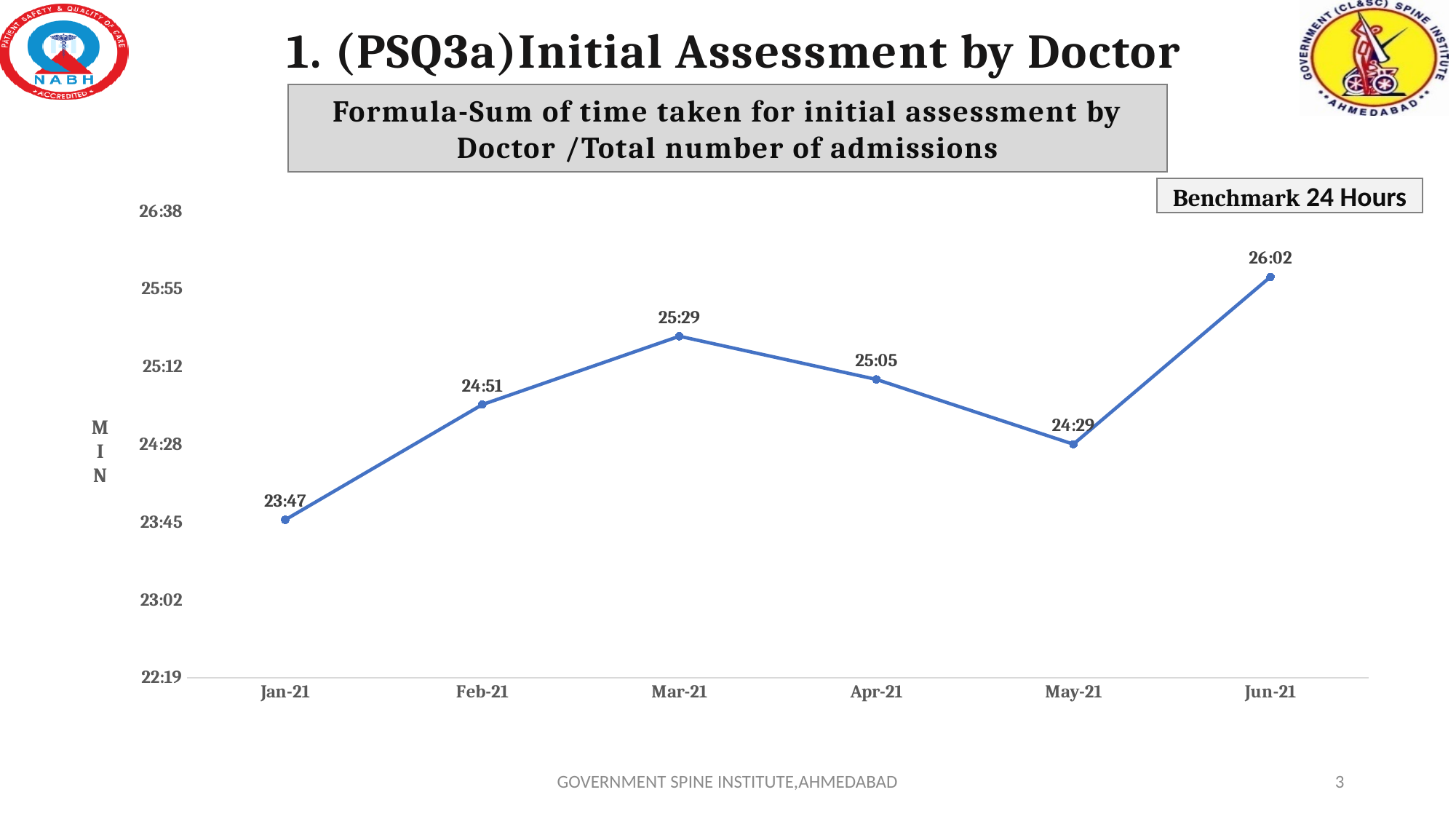
Which is larger, the value for Feb-21 or the value for Apr-21? Apr-21 Does the value rise or fall from Mar-21 to May-21? Fall Which month has the lowest value? Jan-21 By how much does the value for Jun-21 exceed the value for Jan-21? 2:15 What is the value for Mar-21? 25:29 What benchmark is stated on the slide? 24 Hours What is the value for Jun-21? 26:02 What is the value for May-21? 24:29 What kind of chart is shown on the slide? Line chart What is the value for Jan-21? 23:47 Which month has the highest value? Jun-21 How many months are plotted on the chart? 6